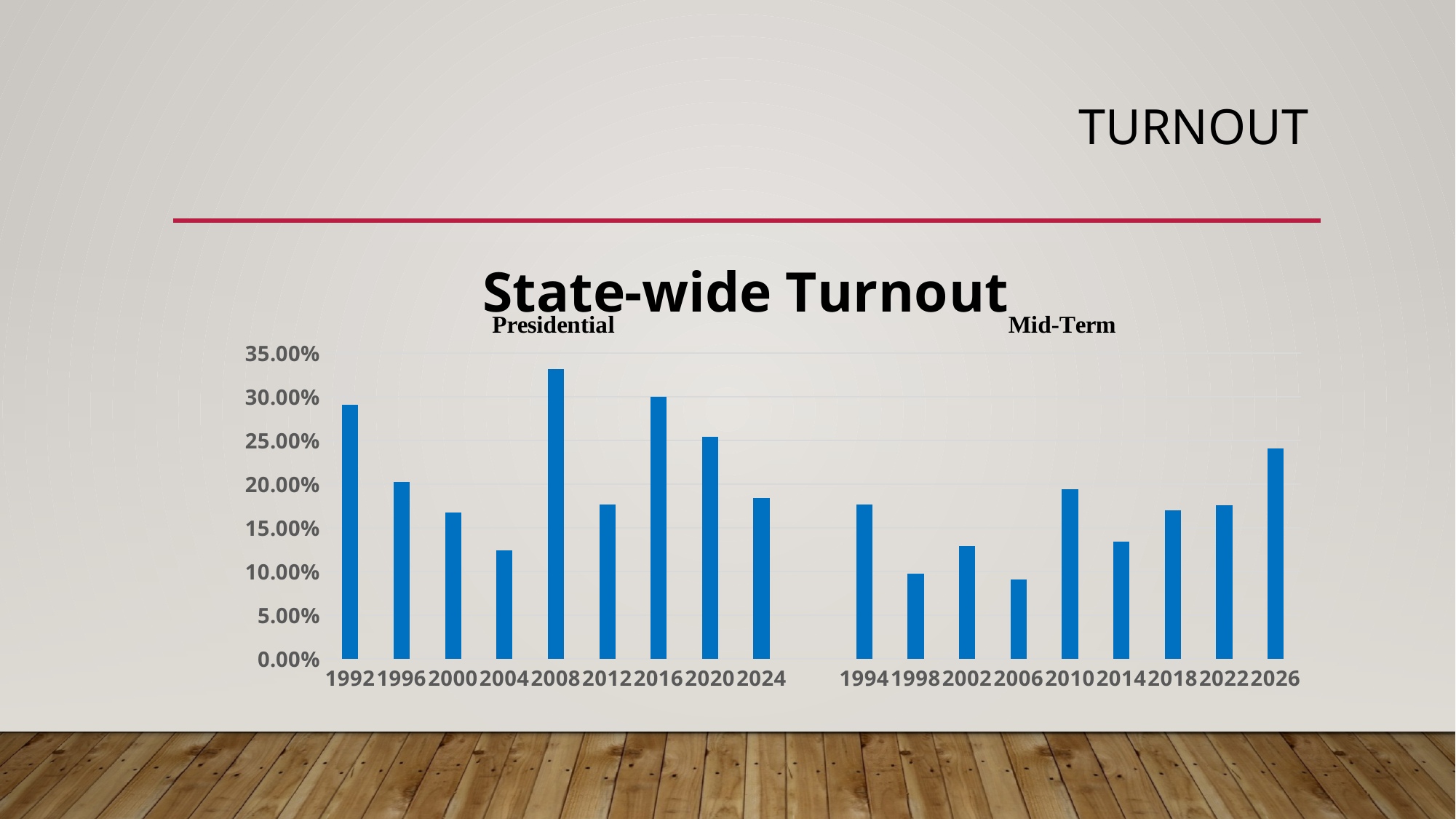
How many Presidential election years are shown on the x axis? 9 Is the turnout for 2014 greater or less than 15.00%? less Which Mid-Term election year has the highest turnout? 2026 Is the turnout for 2006 greater or less than 10.00%? less What are the two groups of elections labelled above the chart? Presidential and Mid-Term What kind of chart is shown on the slide? bar chart Which Presidential election year has the lowest turnout? 2004 Which year has the highest turnout in the chart? 2008 What is the title of the chart? State-wide Turnout Which has the higher turnout, 1992 or 1996? 1992 Is the turnout for 2008 greater or less than 30.00%? greater How many bars are plotted in the chart in total? 18